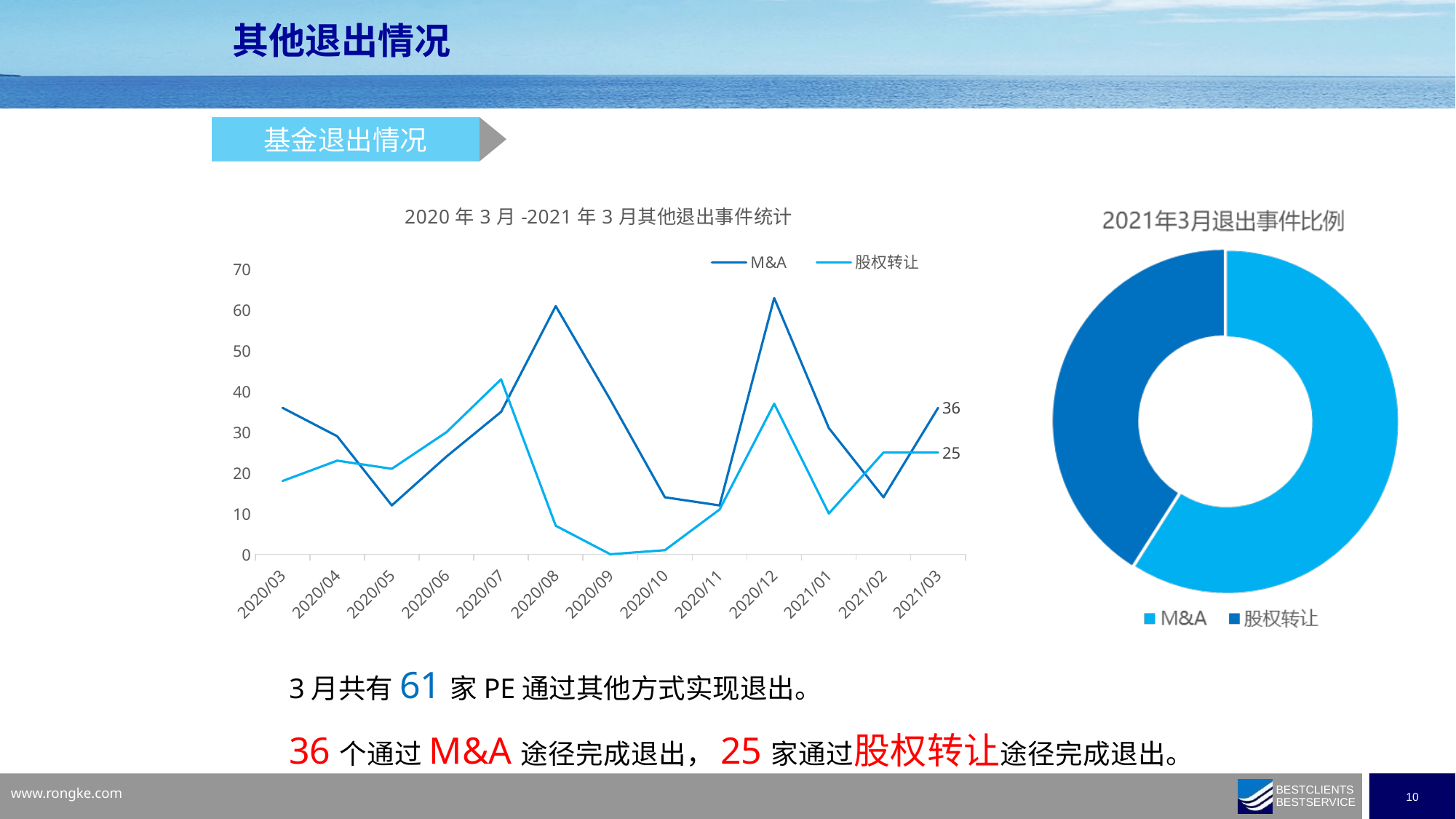
In the left line chart, how many months are shown on the x axis? 13 In the left line chart, is the value for M&A at 2020/08 greater or less than 50? greater In the left line chart, what is the difference between M&A and 股权转让 at 2021/03? 11 What kind of chart is the right chart titled 2021年3月退出事件比例? doughnut (pie) chart In the left line chart, how many series does the legend list? 2 In the left line chart, what is the value of M&A at 2021/03? 36 In the left line chart, in which month does 股权转让 reach its lowest value? 2020/09 In the left line chart, which series has the larger value at 2021/03, M&A or 股权转让? M&A What kind of chart is the left chart titled 2020年3月-2021年3月其他退出事件统计? line chart In the right doughnut chart, which category has the larger share, M&A or 股权转让? M&A In the left line chart, what is the value of 股权转让 at 2021/03? 25 In the left line chart, in which month does 股权转让 reach its highest value? 2020/07